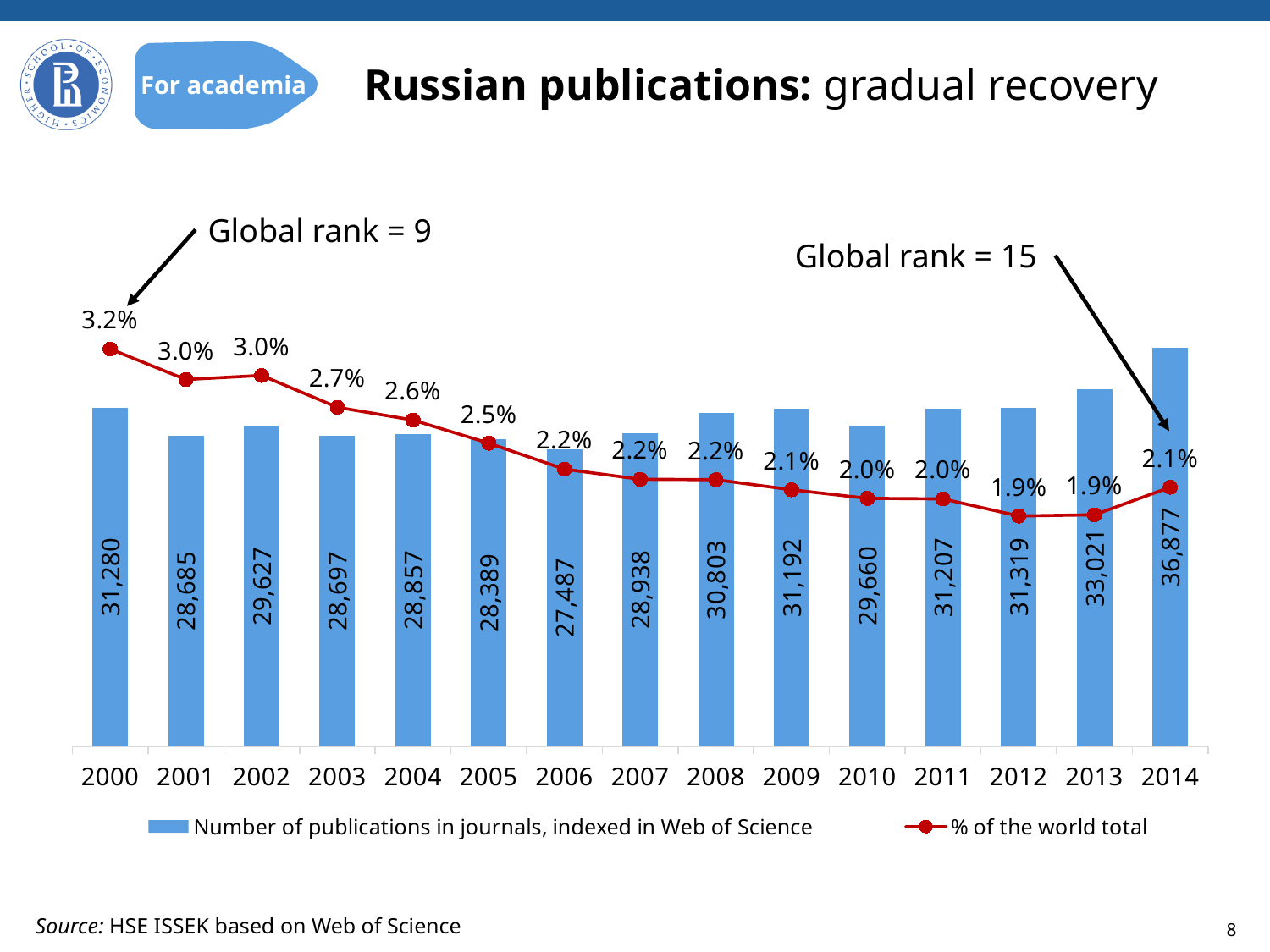
What kind of chart is used to show the number of publications? Bar chart Which year has the lowest number of publications? 2006 What is the % of the world total for 2000? 3.2% What is the number of publications in journals indexed in Web of Science for 2014? 36,877 What is the number of publications for 2006? 27,487 Which year has a larger number of publications, 2000 or 2009? 2000 What global rank is indicated for 2014? 15 How many years are shown on the x axis? 15 Which year has the highest number of publications? 2014 What is the difference in the number of publications between 2014 and 2013? 3,856 Does the % of the world total rise or fall from 2000 to 2012? Fall How many series does the legend list? 2